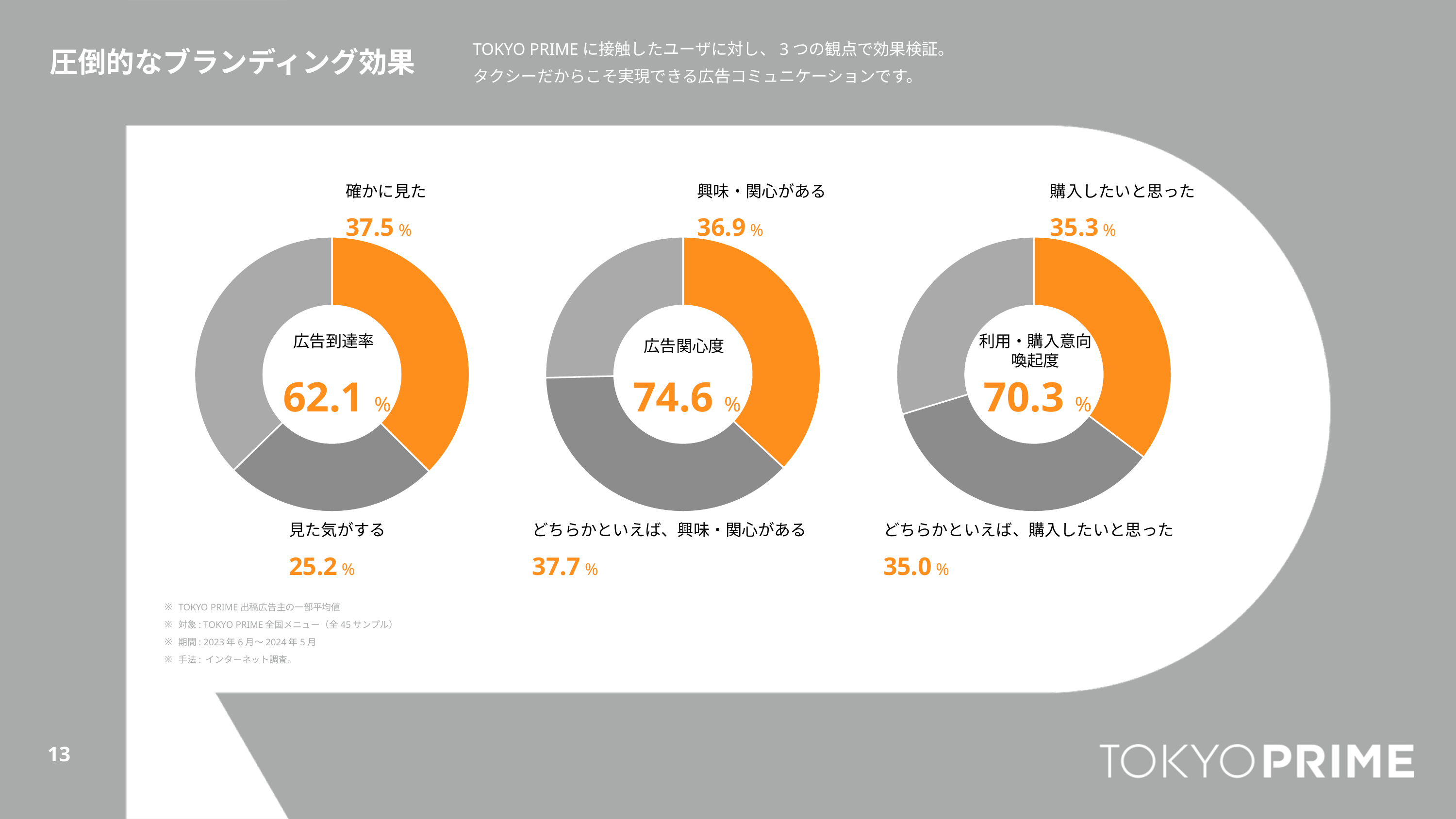
In the right donut chart (利用・購入意向喚起度), what is the value for 購入したいと思った? 35.3% In the left donut chart (広告到達率), what is the value for 見た気がする? 25.2% What kind of chart is used for 広告関心度 in the middle of the slide? Donut (pie) chart In the middle donut chart (広告関心度), what is the value for どちらかといえば、興味・関心がある? 37.7% In the left donut chart (広告到達率), what is the value for 確かに見た? 37.5% How many donut charts are shown on the slide? 3 In the left donut chart (広告到達率), what is the difference between 確かに見た and 見た気がする? 12.3% What is the total value shown in the centre of the left donut chart (広告到達率)? 62.1% In the left donut chart (広告到達率), which is larger: 確かに見た or 見た気がする? 確かに見た In the right donut chart (利用・購入意向喚起度), what is the difference between 購入したいと思った and どちらかといえば、購入したいと思った? 0.3% What is the total value shown in the centre of the right donut chart (利用・購入意向喚起度)? 70.3% In the middle donut chart (広告関心度), what is the value for 興味・関心がある? 36.9%